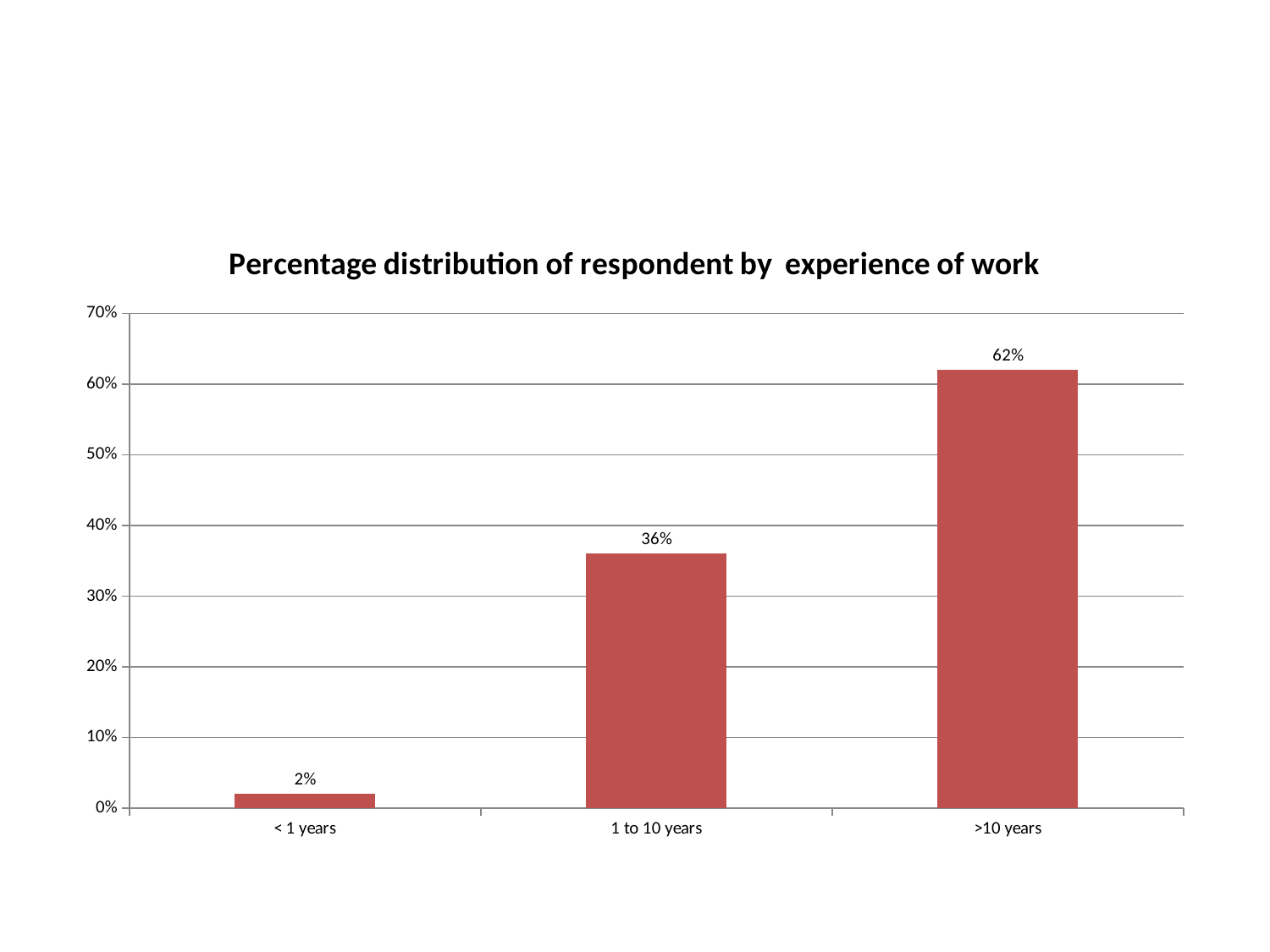
What is the title of the chart? Percentage distribution of respondent by experience of work What percentage of respondents have more than 10 years of work experience? 62% What percentage of respondents have 1 to 10 years of work experience? 36% What percentage of respondents have less than 1 year of work experience? 2% What is the difference in percentage points between the >10 years and 1 to 10 years categories? 26% How many experience categories are shown on the chart? 3 Which experience category has the highest percentage of respondents? >10 years What type of chart is shown on the slide? Bar chart Is the value for >10 years greater or less than 50%? greater Which experience category has the lowest percentage of respondents? < 1 years Which is larger: the percentage for 1 to 10 years or for < 1 years? 1 to 10 years What is the difference in percentage points between the 1 to 10 years and < 1 years categories? 34%